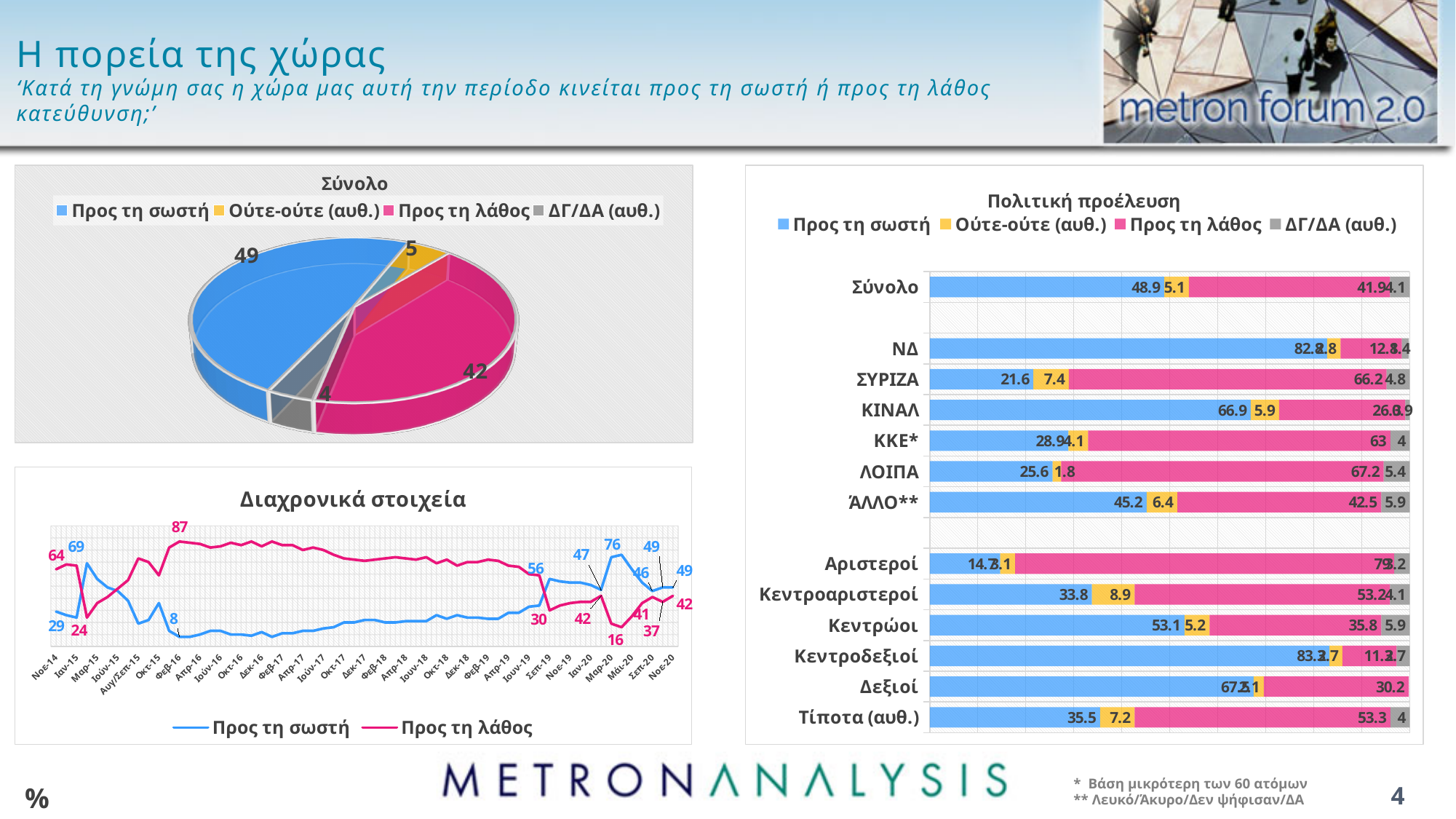
In the 'Διαχρονικά στοιχεία' chart, what is the lowest labelled value of the 'Προς τη σωστή' line? 8 What kind of chart is the 'Πολιτική προέλευση' chart? Stacked bar chart In the 'Πολιτική προέλευση' chart, what is the 'Προς τη λάθος' value for ΣΥΡΙΖΑ? 66.2 In the 'Πολιτική προέλευση' chart, which has the larger 'Προς τη λάθος' value, ΚΚΕ* or ΛΟΙΠΑ? ΛΟΙΠΑ In the 'Σύνολο' pie chart, which category has the largest slice? Προς τη σωστή In the 'Σύνολο' pie chart, which category has the smallest slice? ΔΓ/ΔΑ (αυθ.) In the 'Πολιτική προέλευση' chart, what is the 'Προς τη σωστή' value for Κεντρώοι? 53.1 How many series does the legend of the 'Διαχρονικά στοιχεία' chart list? 2 In the 'Διαχρονικά στοιχεία' chart, what is the value of 'Προς τη σωστή' at Νοε-20? 49 In the 'Σύνολο' pie chart, what is the difference between 'Προς τη σωστή' and 'Προς τη λάθος'? 7 In the 'Διαχρονικά στοιχεία' chart, what is the highest labelled value of the 'Προς τη λάθος' line? 87 In the 'Σύνολο' pie chart, what is the value for 'Προς τη σωστή'? 49